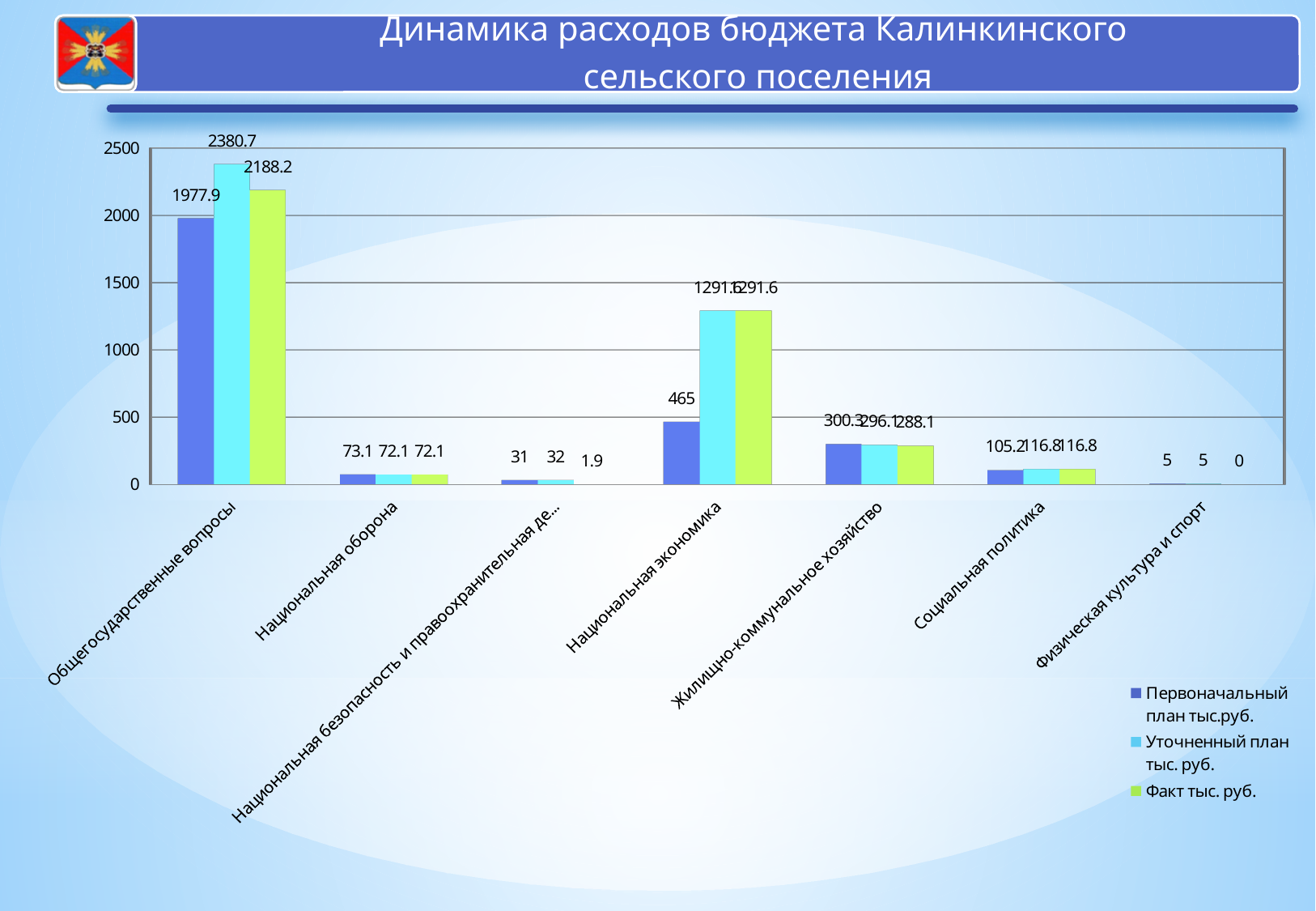
What is the value of Первоначальный план тыс.руб. for Общегосударственные вопросы? 1977.9 What is the value of Факт тыс. руб. for Национальная безопасность и правоохранительная де...? 1.9 Which category has the highest value of Уточненный план тыс. руб.? Общегосударственные вопросы For Общегосударственные вопросы, what is the difference between Уточненный план тыс. руб. and Факт тыс. руб.? 192.5 Which category has the lowest value of Факт тыс. руб.? Физическая культура и спорт For Национальная экономика, how much larger is Уточненный план тыс. руб. than Первоначальный план тыс.руб.? 826.6 How many categories are shown on the x axis of the chart? 7 How many series does the legend list? 3 What is the value of Факт тыс. руб. for Национальная экономика? 1291.6 What kind of chart is shown on the slide? Bar chart What is the value of Уточненный план тыс. руб. for Общегосударственные вопросы? 2380.7 For Социальная политика, which is larger: Первоначальный план тыс.руб. or Уточненный план тыс. руб.? Уточненный план тыс. руб.